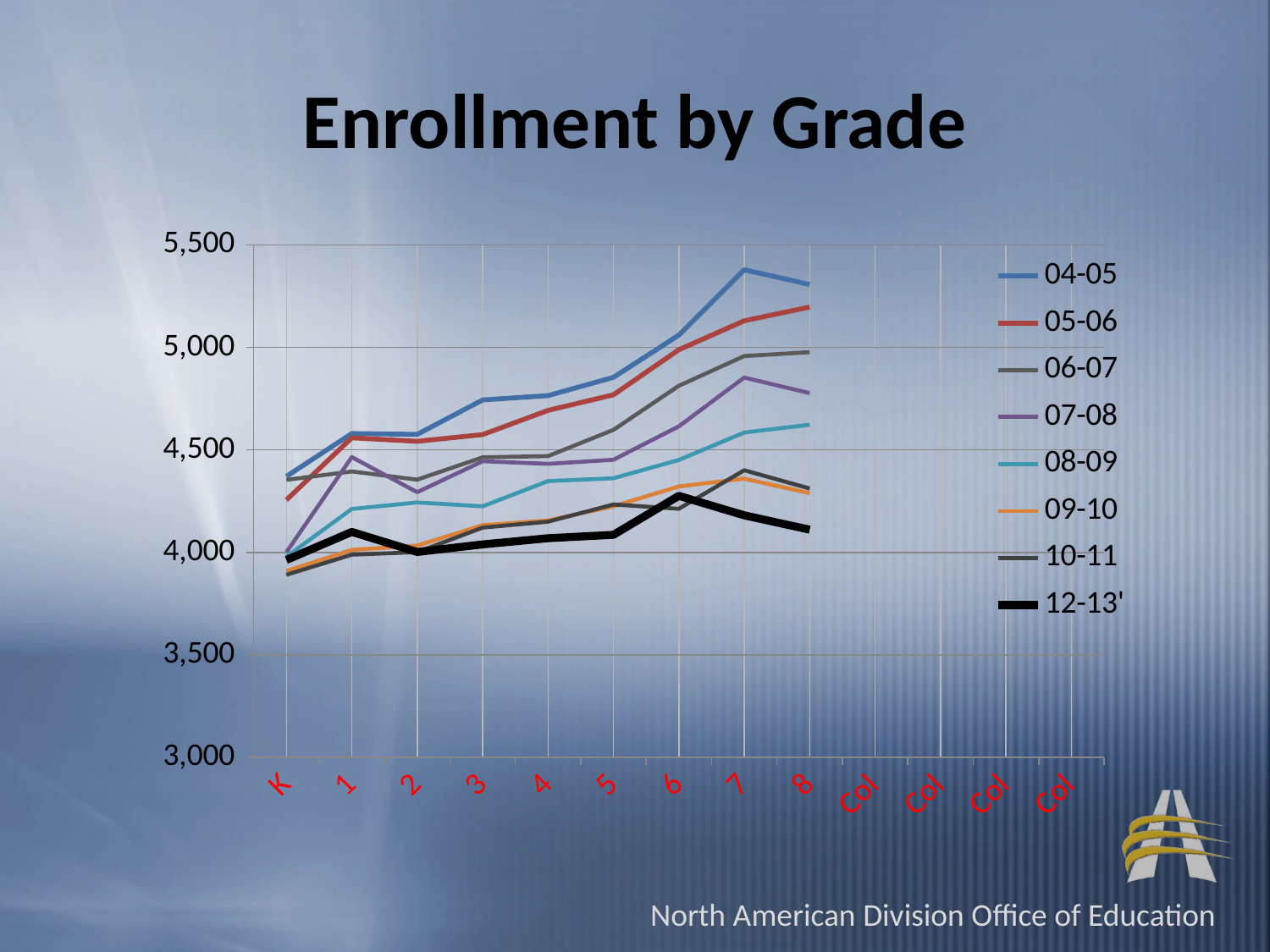
Which series has the highest value at grade 8? 04-05 Does the 04-05 series rise or fall from grade K to grade 7? rise Which series is drawn with a thick black line? 12-13' Is the value for 04-05 at grade 7 greater or less than 5,000? greater Is the value for 12-13' at grade 8 greater or less than 4,500? less What is the title of the chart? Enrollment by Grade Which series has the lowest value at grade 8? 12-13' What kind of chart is shown on the slide? line chart At grade 7, which is larger: the value for 04-05 or the value for 12-13'? 04-05 Is the value for 05-06 at grade 8 greater or less than 5,000? greater How many series does the legend list? 8